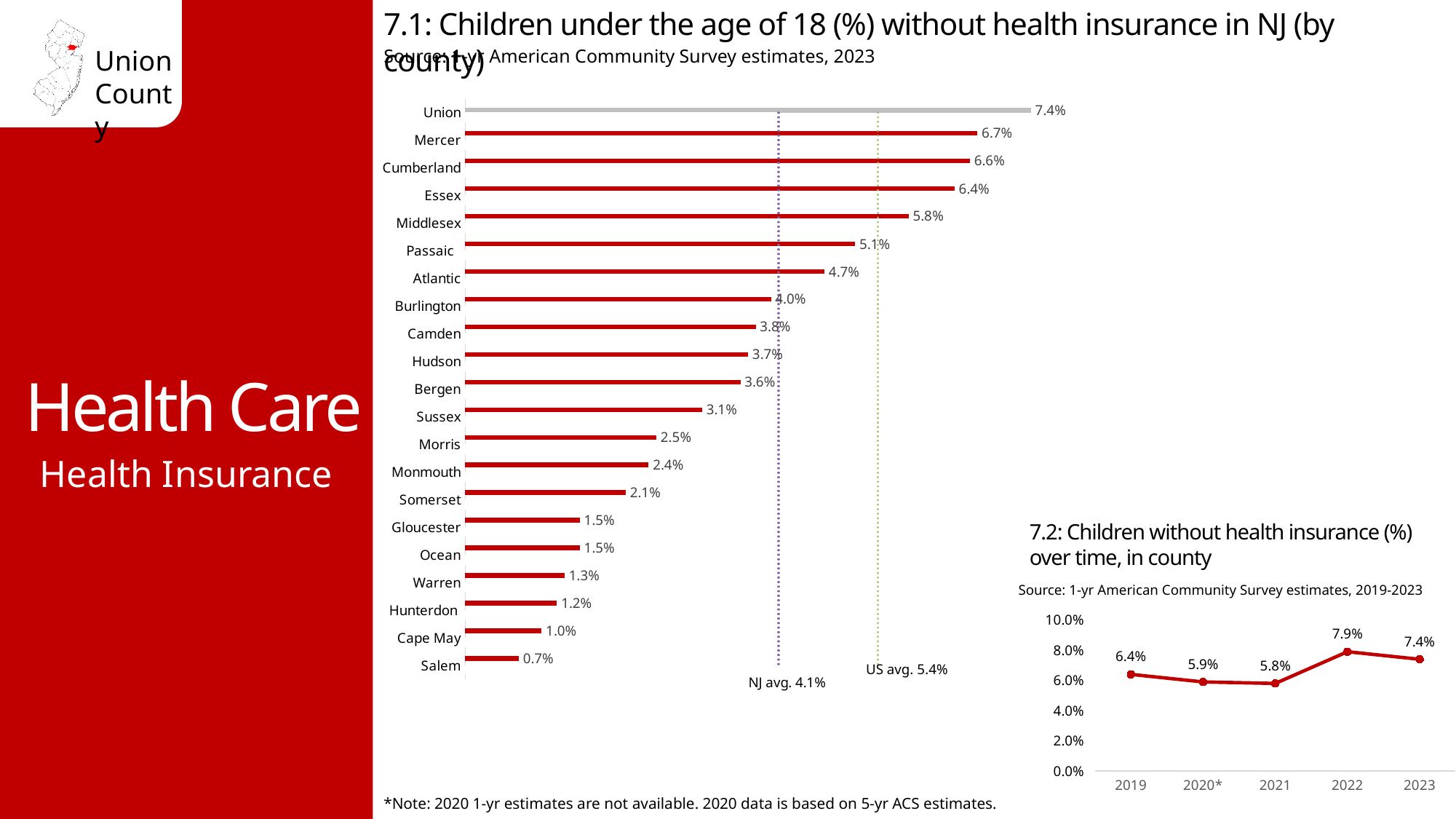
In chart 7.2, what is the value for 2022? 7.9% In chart 7.2, what is the difference between 2022 and 2023? 0.5% In chart 7.1, which is larger, the value for Bergen or the value for Sussex? Bergen What kind of chart is chart 7.1? Bar chart In chart 7.2, which year has the lowest value? 2021 In chart 7.1, which county has the lowest value? Salem In chart 7.1, what is the NJ average shown by the dotted line? 4.1% In chart 7.1, what is the value for Passaic? 5.1% In chart 7.1, what is the value for Union? 7.4% In chart 7.1, what is the difference between Mercer and Essex? 0.3% In chart 7.1, how many counties are shown? 21 In chart 7.1, which county has the highest value? Union